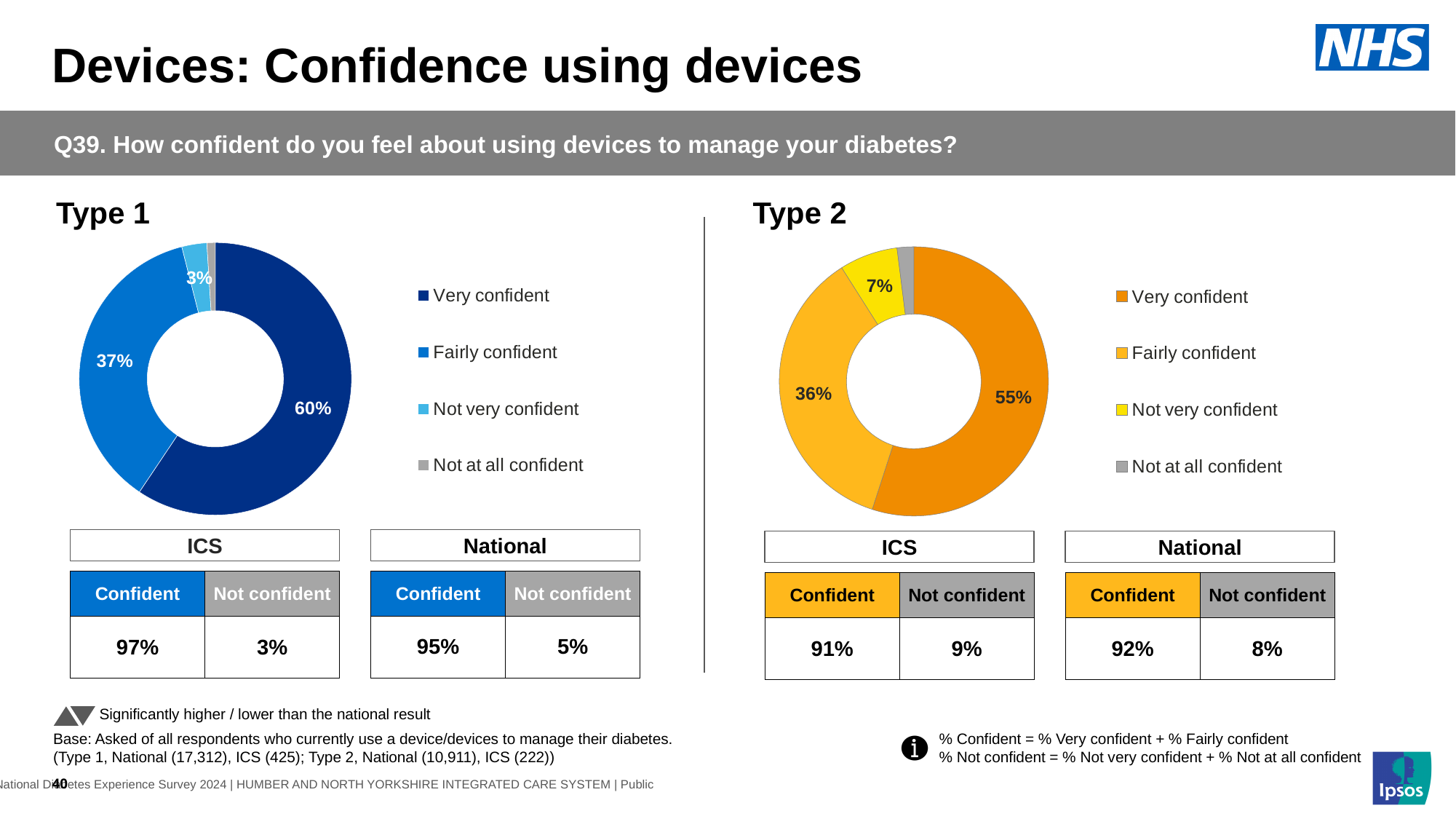
In the Type 2 chart, what percentage of respondents are fairly confident? 36% In the Type 1 chart, which category has the largest share? Very confident In the Type 1 chart, what is the difference between the very confident and fairly confident shares? 23 percentage points In the Type 2 chart, what is the difference between the very confident and not very confident shares? 48 percentage points Which is larger: the very confident share in the Type 1 chart or the very confident share in the Type 2 chart? Type 1 What kind of chart is used for Type 1? Pie (donut) chart In the Type 1 chart, is the fairly confident share larger or smaller than the not very confident share? Larger In the Type 1 chart, what percentage of respondents are very confident? 60% In the Type 2 chart, what percentage of respondents are not very confident? 7% How many categories does the legend of the Type 2 chart list? 4 What colour represents 'Not at all confident' in the Type 1 chart? Grey In the Type 2 chart, which category has the smallest share? Not at all confident